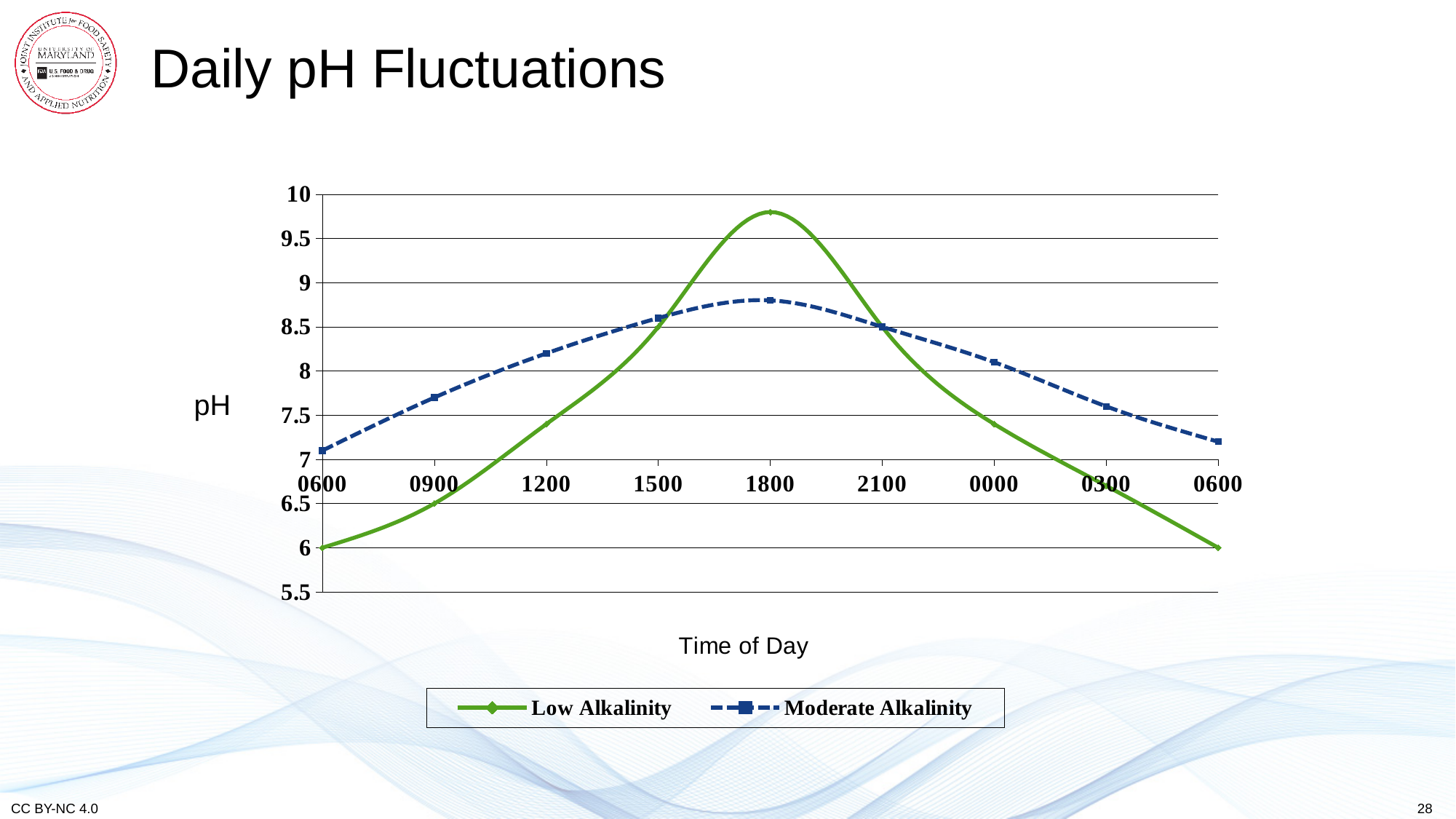
What is the pH value for Low Alkalinity at 0900? 6.5 How many series does the legend list? 2 At 1800, which series has the higher pH, Low Alkalinity or Moderate Alkalinity? Low Alkalinity What is the pH value for Low Alkalinity at 2100? 8.5 At which time of day does the Moderate Alkalinity series reach its highest pH? 1800 At which time of day does the Low Alkalinity series reach its highest pH? 1800 What kind of chart is shown on the slide? line chart What is the pH value for Low Alkalinity at the first 0600 point? 6 What is the label on the y axis of the chart? pH Is the Moderate Alkalinity pH at 1800 greater or less than 9? less How many time-of-day points are plotted along the x axis? 9 Is the Low Alkalinity pH at 1800 greater or less than 9.5? greater